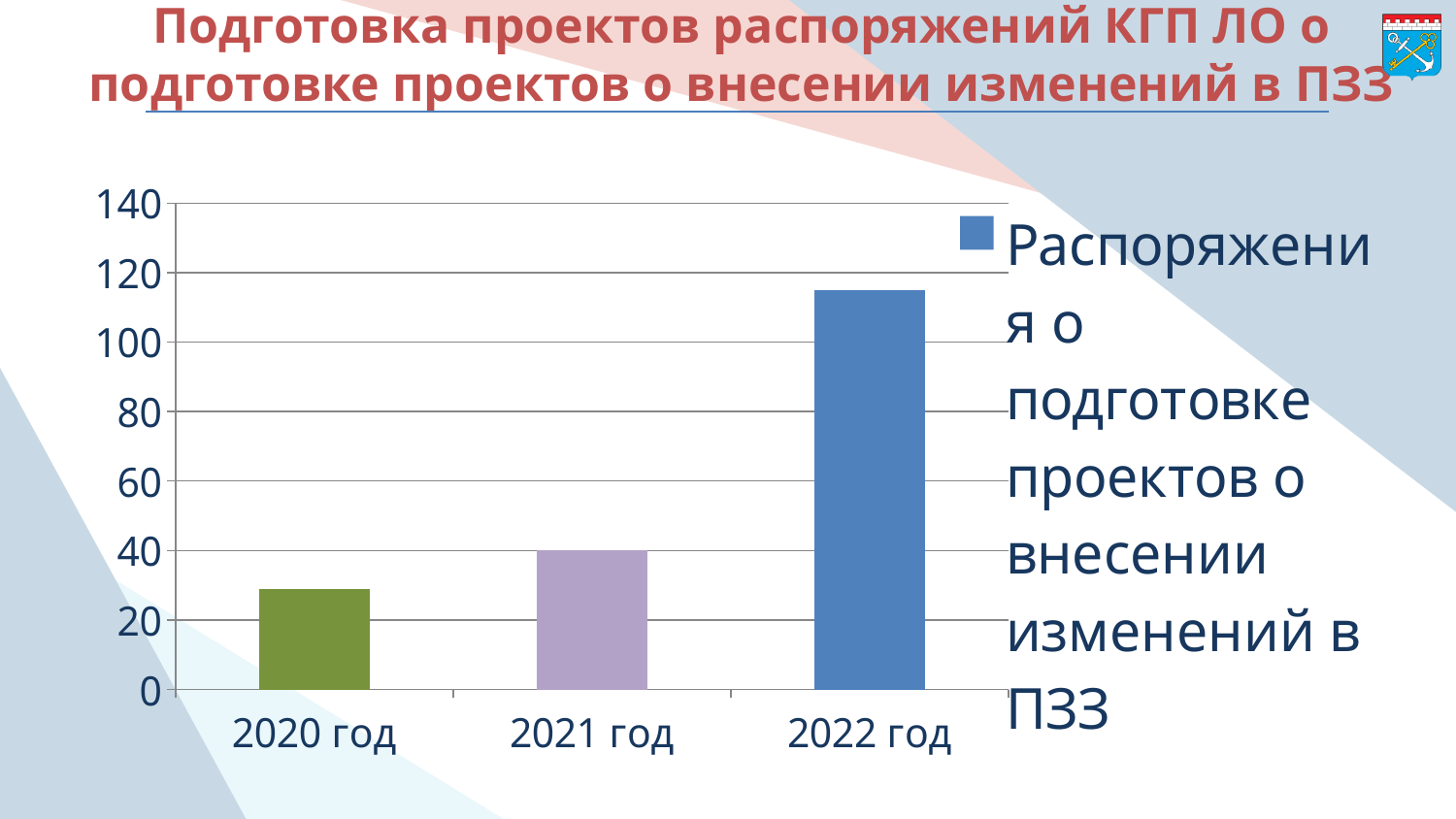
Which is larger, the value for 2021 год or the value for 2020 год? 2021 год Is the value for 2020 год greater or less than 40? less Is the value for 2022 год greater or less than 120? less How many series does the chart legend list? 1 Is the value for 2022 год greater or less than 100? greater Which year has the highest bar in the chart? 2022 год What is the value for 2021 год according to the axis tick the bar reaches? 40 What kind of chart is shown on the slide? bar chart What colour is the bar for 2020 год? green Do the values rise or fall from 2020 год to 2022 год? rise How many categories (years) are shown on the x axis of the chart? 3 Which year has the lowest bar in the chart? 2020 год